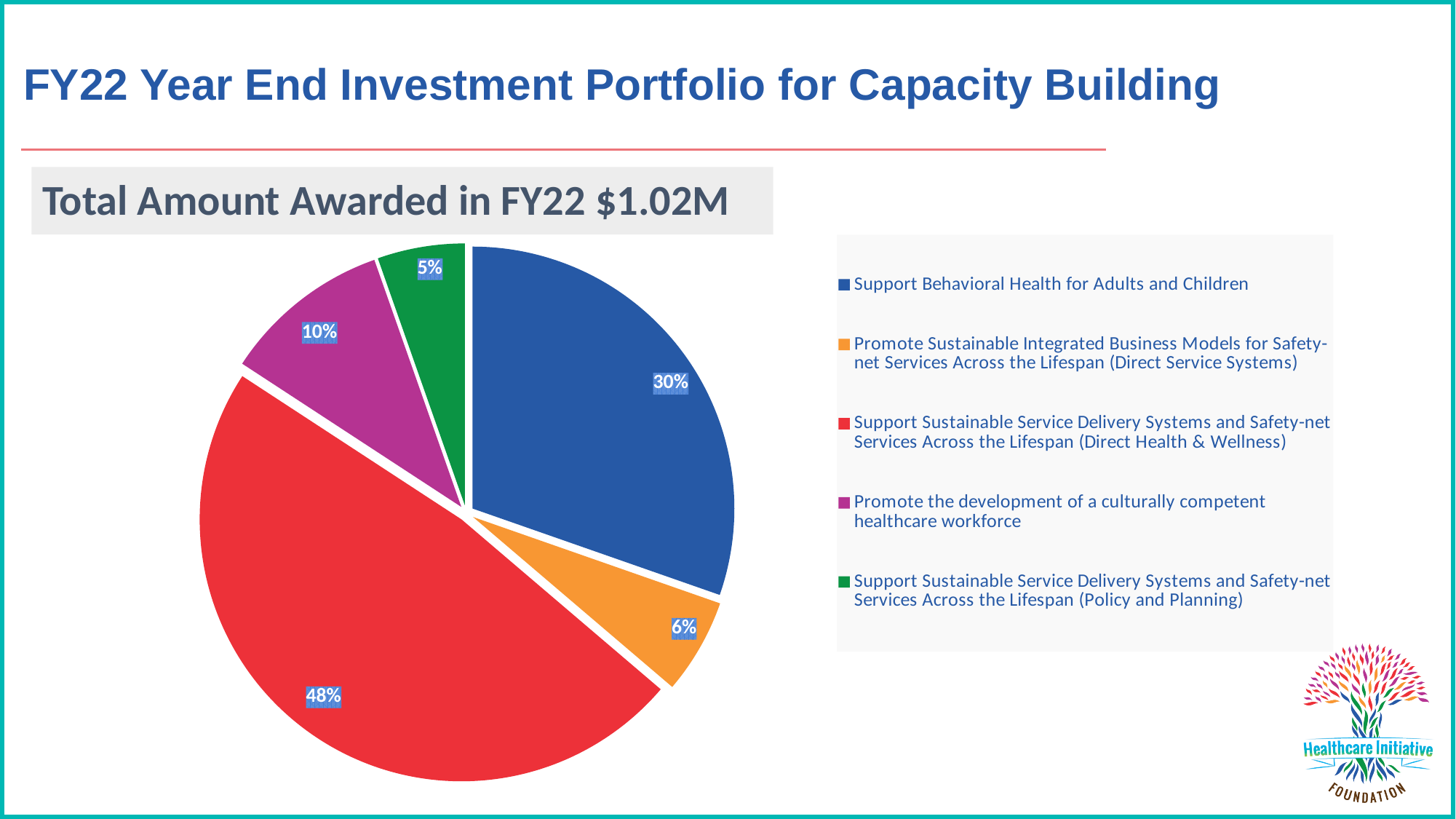
What total amount awarded in FY22 is stated above the chart? $1.02M Which is larger: the slice for Promote the development of a culturally competent healthcare workforce or the slice for Promote Sustainable Integrated Business Models (Direct Service Systems)? Promote the development of a culturally competent healthcare workforce Which category has the smallest slice of the pie? Support Sustainable Service Delivery Systems and Safety-net Services Across the Lifespan (Policy and Planning) What share of the pie does Support Sustainable Service Delivery Systems and Safety-net Services Across the Lifespan (Direct Health & Wellness) represent? 48% What share of the pie does Support Sustainable Service Delivery Systems and Safety-net Services Across the Lifespan (Policy and Planning) represent? 5% What kind of chart is shown on the slide? Pie chart How many categories are shown in the pie chart? 5 What share of the pie does Support Behavioral Health for Adults and Children represent? 30% Which category has the largest slice of the pie? Support Sustainable Service Delivery Systems and Safety-net Services Across the Lifespan (Direct Health & Wellness) What is the difference in percentage points between the Direct Health & Wellness slice and the Support Behavioral Health for Adults and Children slice? 18